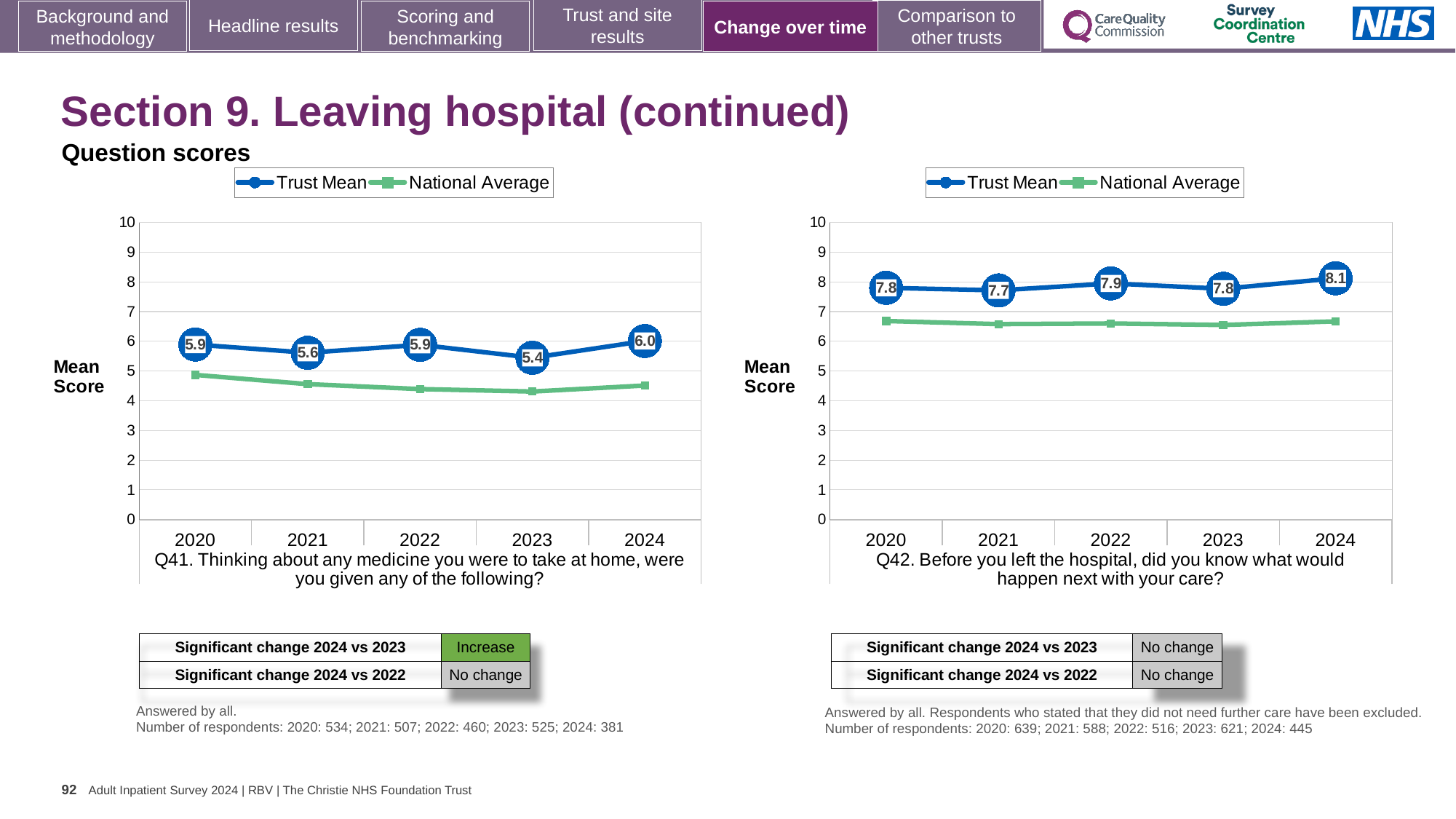
How many series does the legend of the Q41 chart (left) list? 2 On the Q41 chart (left), what is the Trust Mean score for 2024? 6.0 How many years are plotted on the Q42 chart (right)? 5 On the Q41 chart (left), which year has the lowest Trust Mean score? 2023 On the Q41 chart (left), what is the difference between the Trust Mean scores for 2024 and 2023? 0.6 On the Q42 chart (right), what is the Trust Mean score for 2022? 7.9 On the Q41 chart (left), what is the Trust Mean score for 2023? 5.4 On the Q41 chart (left), is the National Average for 2020 greater or less than 5? less What type of chart is the Q41 chart (left)? Line chart On the Q42 chart (right), is the National Average for 2024 greater or less than 7? less On the Q42 chart (right), which is larger, the Trust Mean for 2021 or for 2024? 2024 On the Q42 chart (right), which year has the highest Trust Mean score? 2024